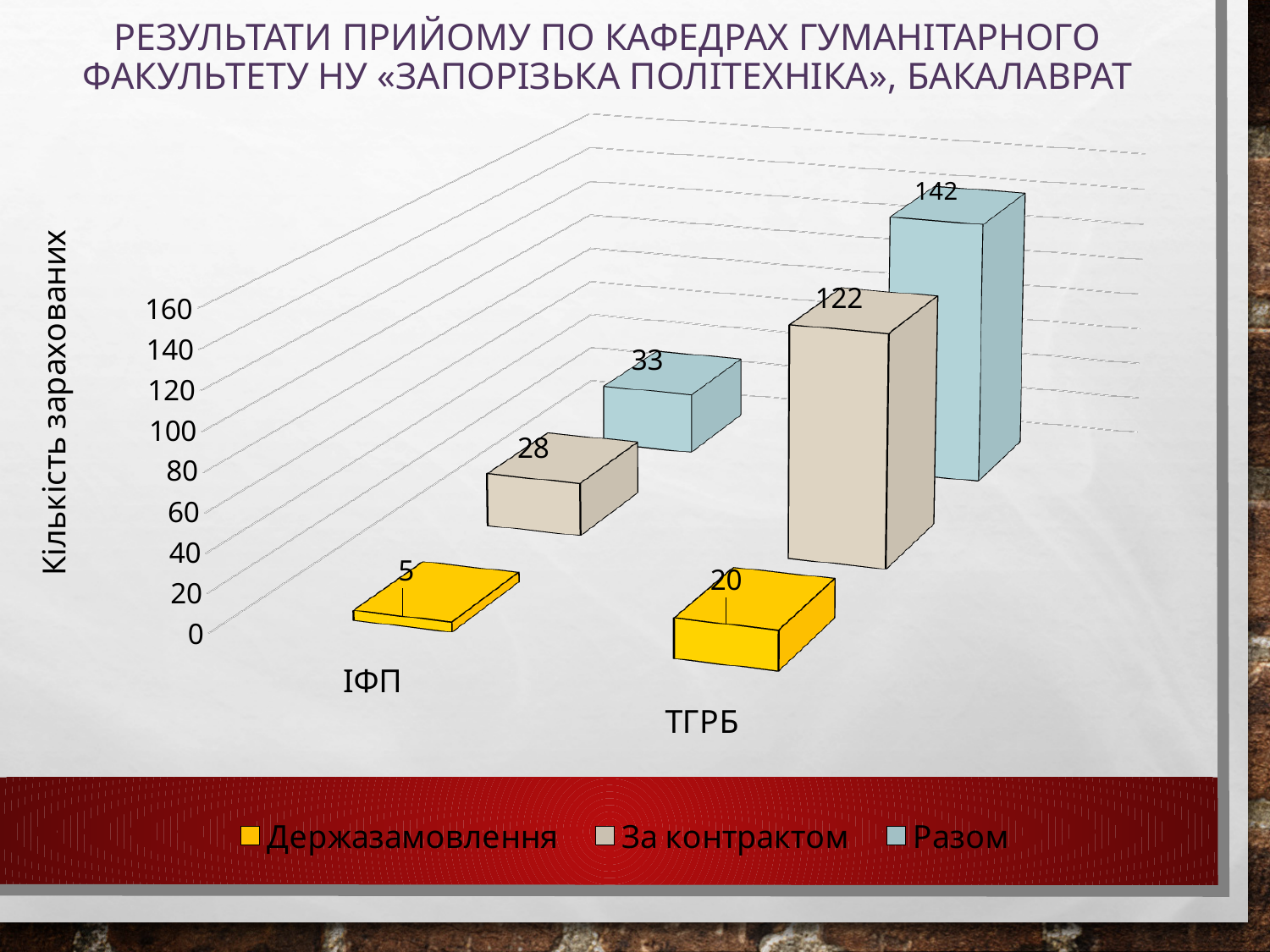
What is the value for Держазамовлення for ІФП? 5 What is the value for Разом for ІФП? 33 How many series does the legend list? 3 What is the value for За контрактом for ТГРБ? 122 Which category has the lowest value for За контрактом? ІФП Which is larger: За контрактом for ІФП or Держазамовлення for ТГРБ? За контрактом for ІФП What is the value for Держазамовлення for ТГРБ? 20 Which category has the highest value for Разом? ТГРБ What is the label of the vertical axis? Кількість зарахованих What is the difference between the Разом values for ТГРБ and ІФП? 109 What kind of chart is shown on the slide? Bar chart How many categories are shown on the x axis? 2